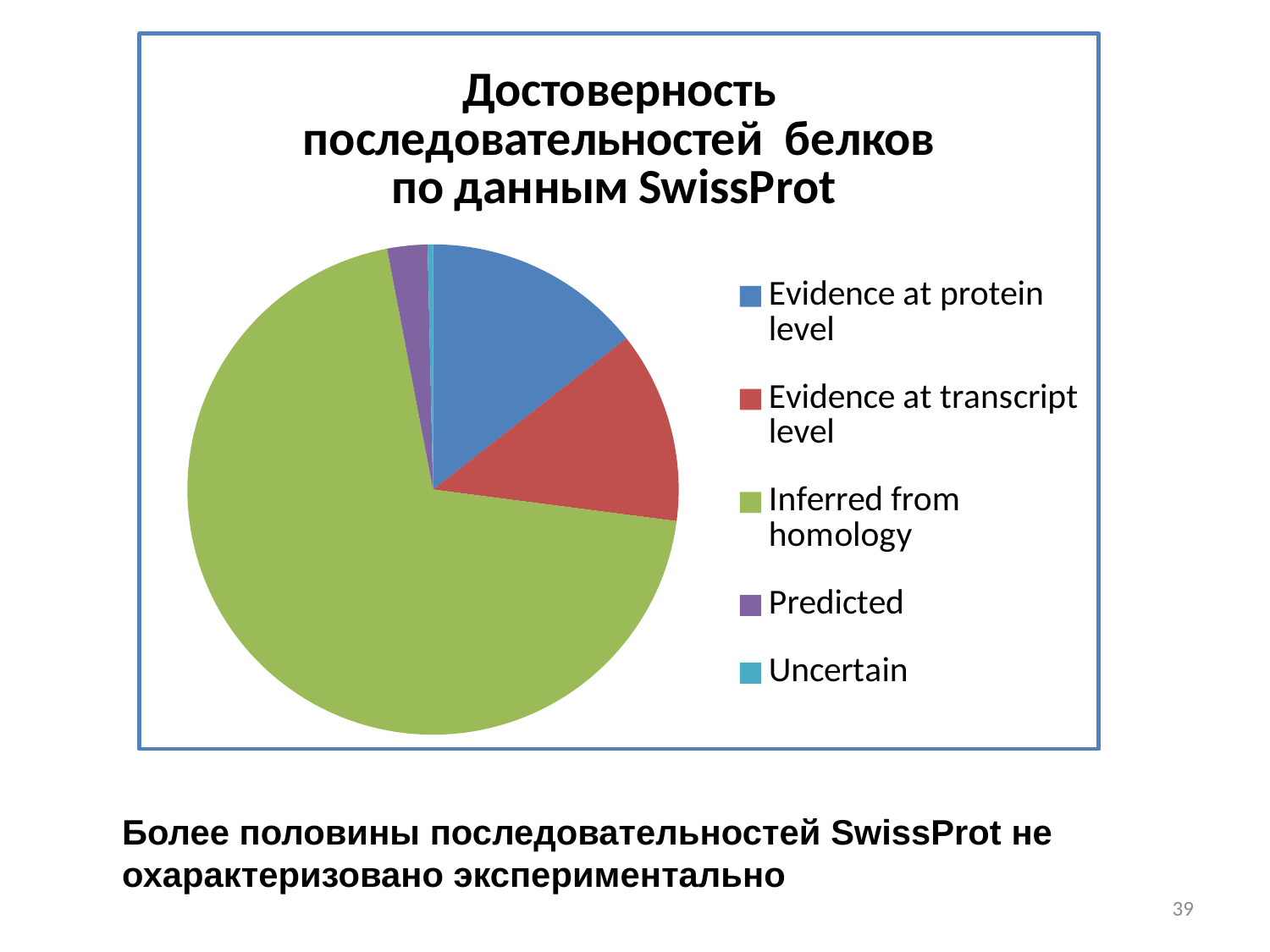
Which slice is larger: Evidence at protein level or Predicted? Evidence at protein level Which slice is larger: Evidence at transcript level or Uncertain? Evidence at transcript level Which category has the largest slice of the pie chart? Inferred from homology Which slice is larger: Predicted or Uncertain? Predicted Which category is shown in blue in the pie chart? Evidence at protein level What colour is the Inferred from homology slice in the pie chart? green How many categories (slices) does the pie chart have? 5 What kind of chart is shown on the slide? pie chart Which category has the smallest slice of the pie chart? Uncertain